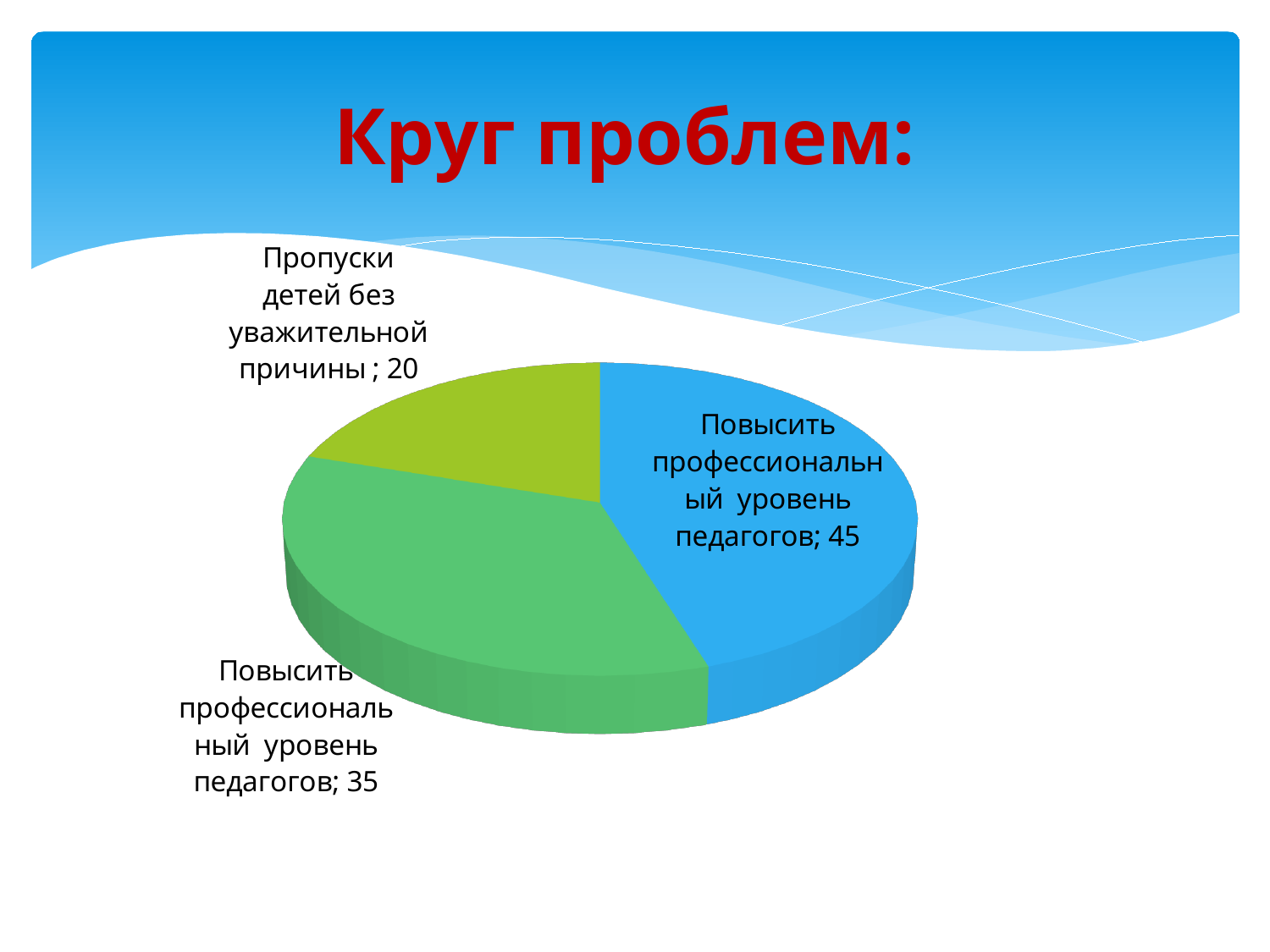
What kind of chart is shown on the slide? pie chart What is the total of all slice values in the pie chart? 100 Which category has the smallest slice in the pie chart? Пропуски детей без уважительной причины How many slices does the pie chart have? 3 What is the difference between the blue slice and the green slice? 10 What is the value of the largest slice in the pie chart? 45 What is the value for "Пропуски детей без уважительной причины"? 20 Which is larger, the blue slice or the green slice? the blue slice What is the difference between the largest slice (45) and the slice for "Пропуски детей без уважительной причины"? 25 What is the value of the blue slice of the pie chart? 45 What is the value of the green slice of the pie chart? 35 What is the title of the slide? Круг проблем: